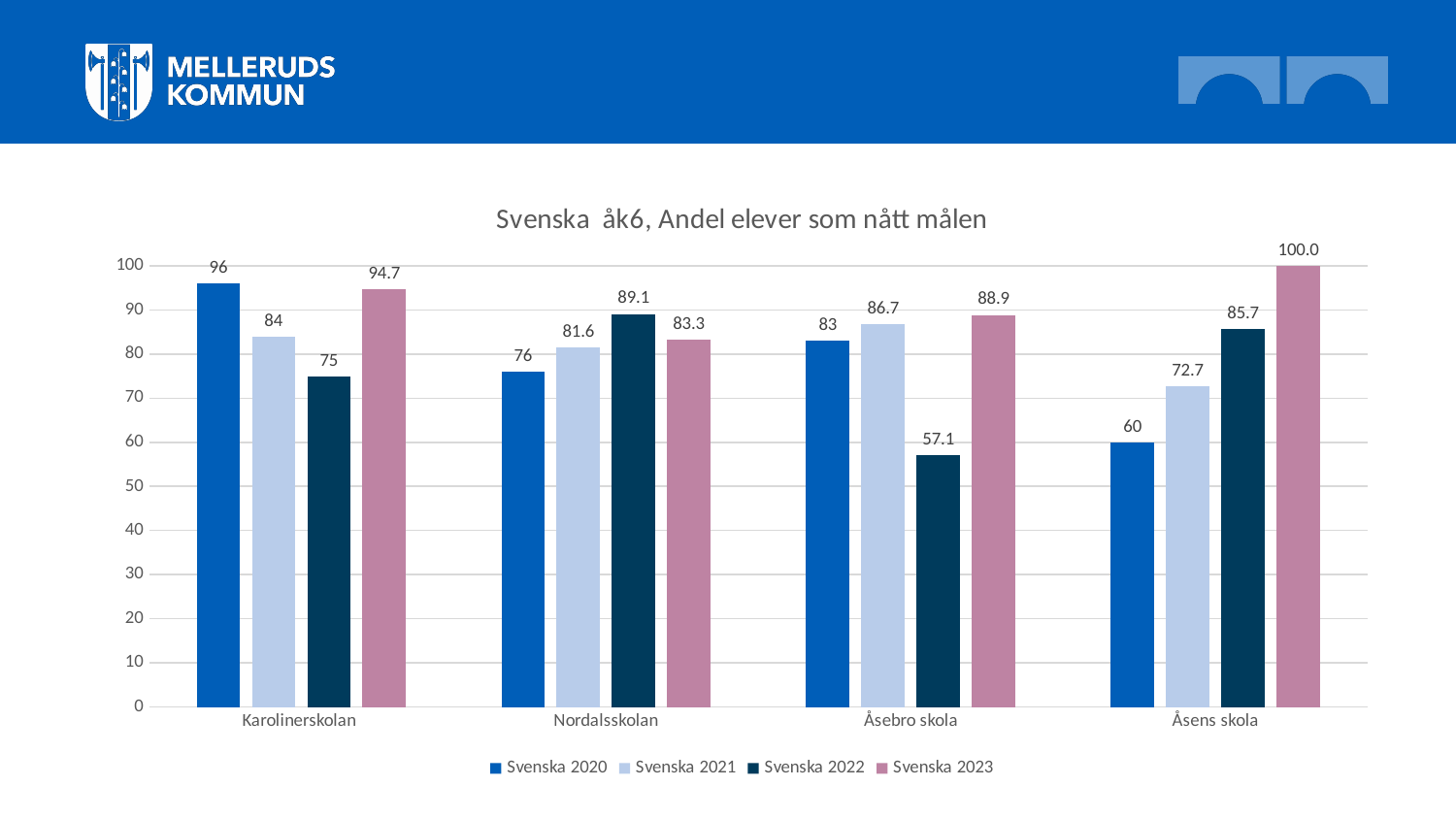
Which school has the lowest value in the Svenska 2020 series? Åsens skola What is the difference between the Svenska 2020 and Svenska 2022 values for Karolinerskolan? 21 What is the value for Åsebro skola in the Svenska 2022 series? 57.1 What is the value for Karolinerskolan in the Svenska 2020 series? 96 How many series does the legend list? 4 What is the value for Nordalsskolan in the Svenska 2021 series? 81.6 What is the value for Åsens skola in the Svenska 2023 series? 100.0 How many schools are shown on the x axis? 4 Which school has the highest value in the Svenska 2023 series? Åsens skola What is the title of the chart? Svenska åk6, Andel elever som nått målen Which is larger for Nordalsskolan: the Svenska 2022 value or the Svenska 2023 value? Svenska 2022 What kind of chart is shown on the slide? Bar chart